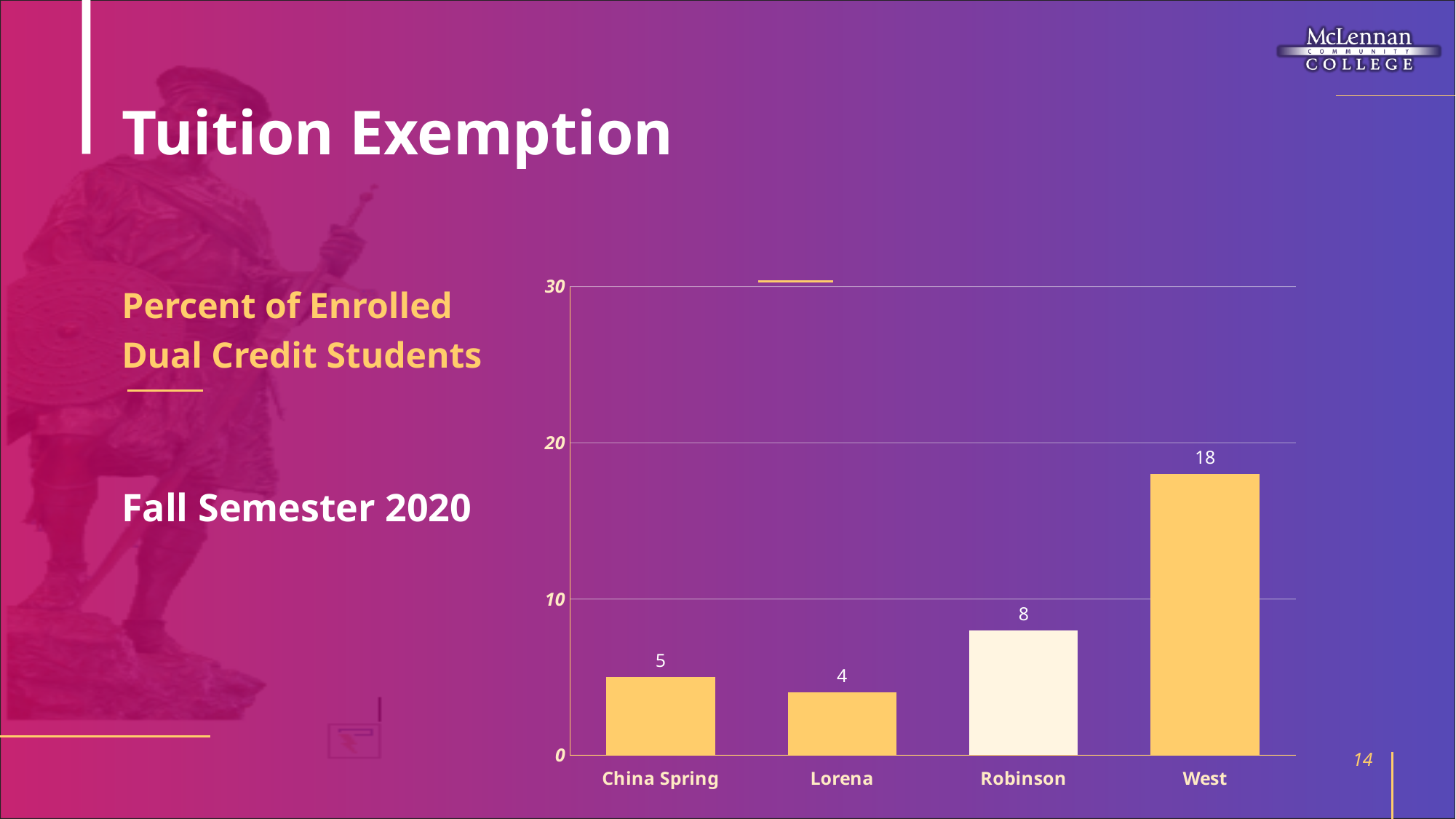
What kind of chart is shown on the slide? bar chart How many categories are shown on the x axis? 4 Which category has the highest value? West Which category has the lowest value? Lorena What is the value for Robinson? 8 What is the difference between the values for West and Robinson? 10 Is the value for West greater or less than 20? less Which is larger, the value for China Spring or the value for Lorena? China Spring What is the highest value shown on the y axis? 30 What is the value for West? 18 What is the value for China Spring? 5 What is the value for Lorena? 4